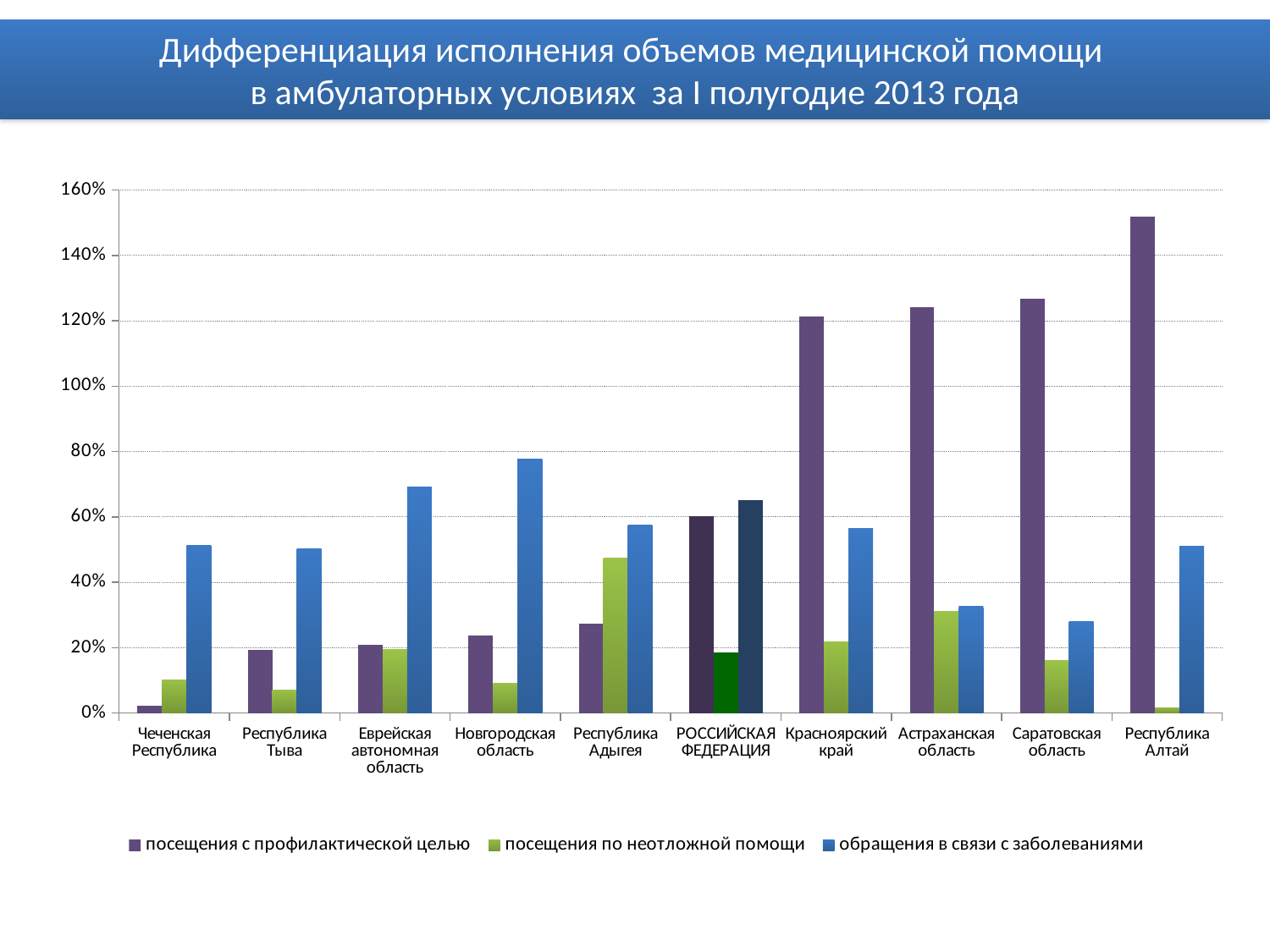
Which region has the highest value for 'посещения по неотложной помощи'? Республика Адыгея How many regions (categories) are shown along the x axis? 10 Is the value for 'обращения в связи с заболеваниями' in Новгородская область greater or less than 60%? greater What kind of chart is shown on the slide? bar chart How many series does the legend list? 3 Which is larger for 'обращения в связи с заболеваниями': Еврейская автономная область or Республика Адыгея? Еврейская автономная область Which region has the lowest value for 'посещения по неотложной помощи'? Республика Алтай Is the value for 'посещения с профилактической целью' in Республика Алтай greater or less than 140%? greater Which region has the highest value for 'обращения в связи с заболеваниями'? Новгородская область Which region has the highest value for 'посещения с профилактической целью'? Республика Алтай Which region has the lowest value for 'посещения с профилактической целью'? Чеченская Республика What is the title of the chart on the slide? Дифференциация исполнения объемов медицинской помощи в амбулаторных условиях за I полугодие 2013 года